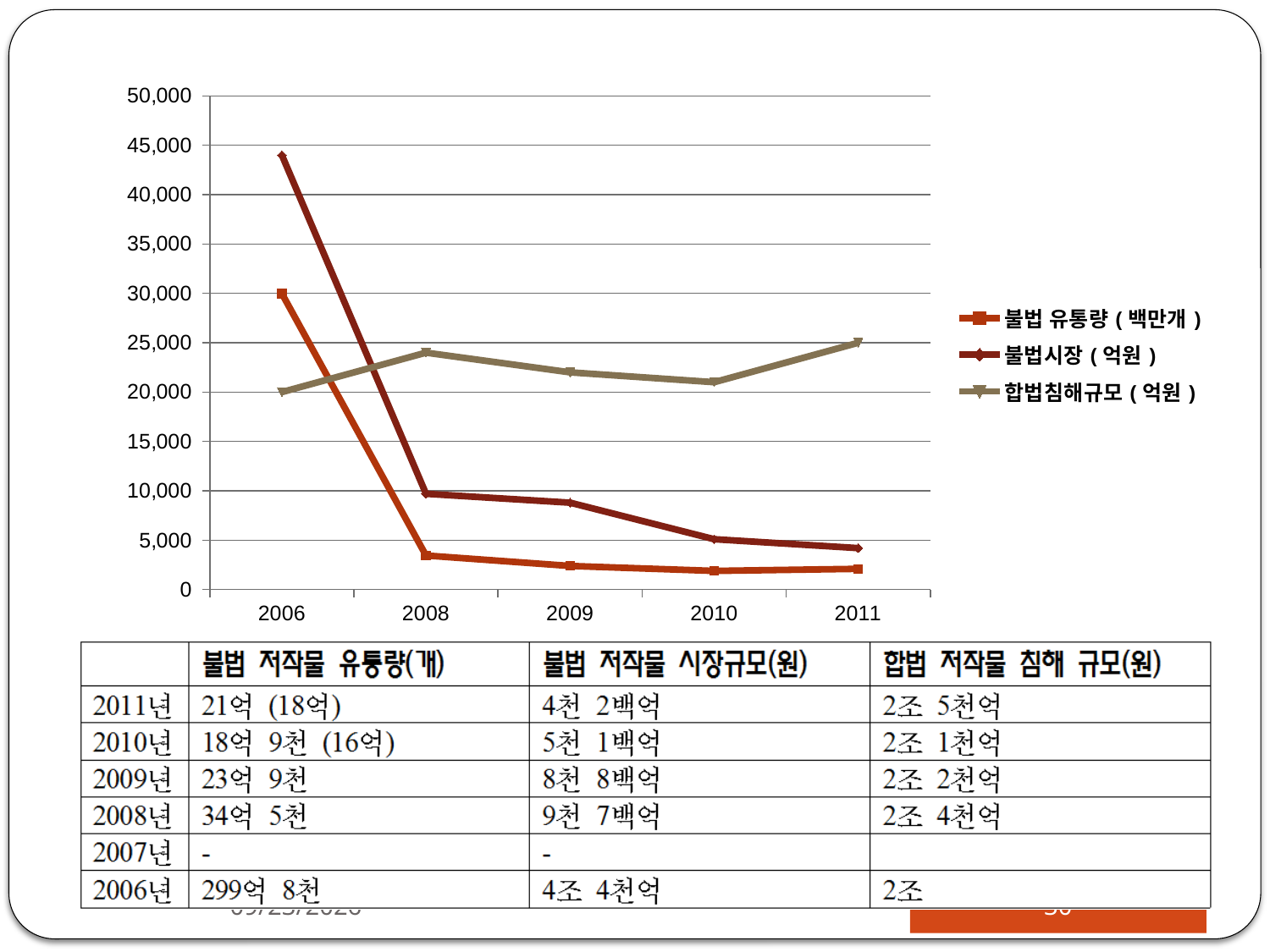
Is the value for 불법시장 ( 억원 ) in 2006 greater or less than 40,000? greater What is the value of 합법침해규모 ( 억원 ) in 2011? 25,000 What is the value of 합법침해규모 ( 억원 ) in 2006? 20,000 In 2008, which is larger: 합법침해규모 ( 억원 ) or 불법시장 ( 억원 )? 합법침해규모 ( 억원 ) Is the value for 합법침해규모 ( 억원 ) in 2009 greater or less than 20,000? greater In 2006, which is larger: 불법시장 ( 억원 ) or 불법 유통량 ( 백만개 )? 불법시장 ( 억원 ) How many series does the chart's legend list? 3 Does 불법시장 ( 억원 ) rise or fall from 2006 to 2011? fall In which year is 불법시장 ( 억원 ) highest? 2006 What type of chart is shown on the slide? line chart Is the value for 불법 유통량 ( 백만개 ) in 2008 greater or less than 5,000? less How many years are shown on the x axis of the chart? 5